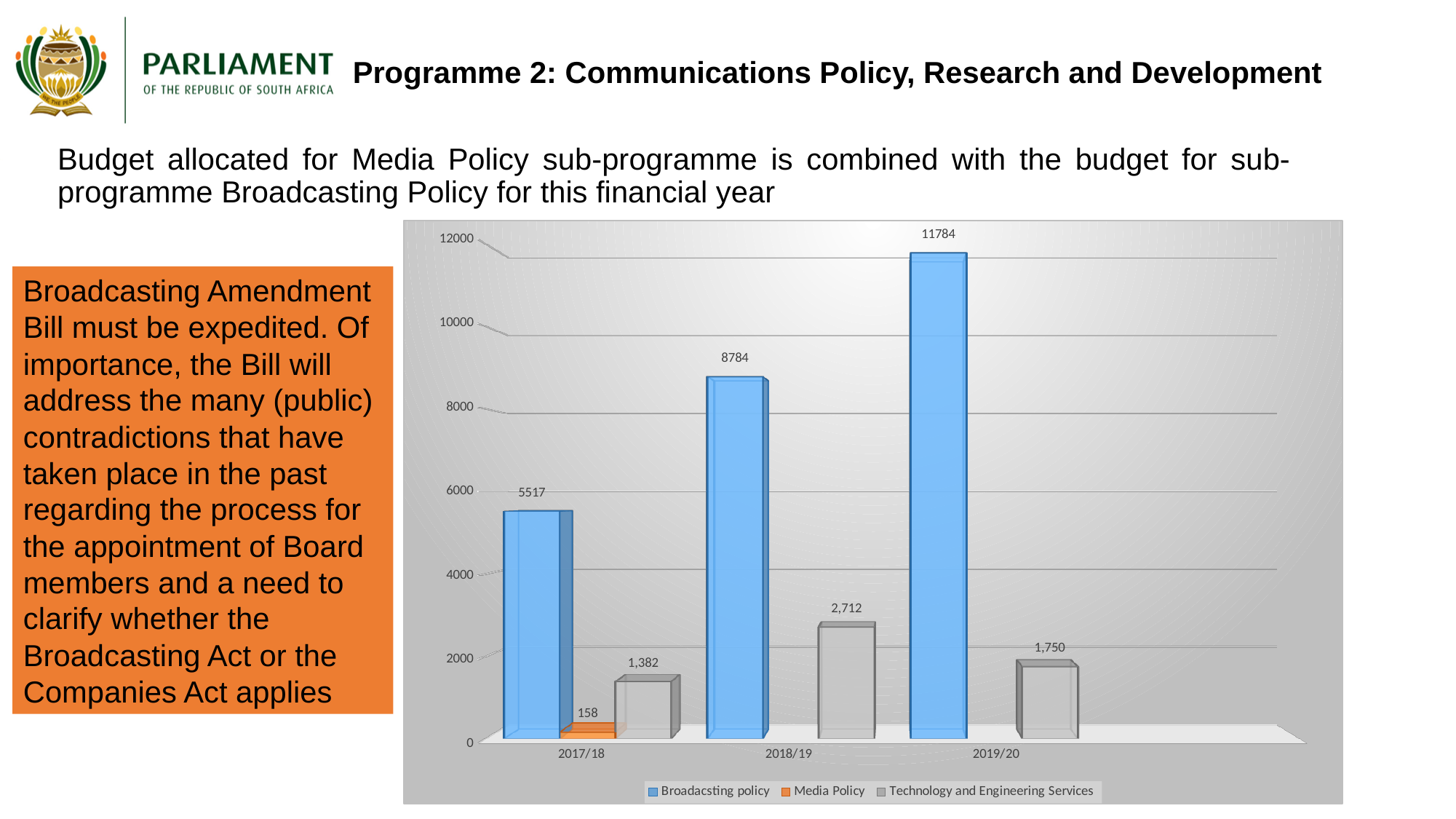
Which is larger: Technology and Engineering Services in 2018/19 or in 2019/20? 2018/19 What is the value for Broadcasting policy in 2019/20? 11784 In which year is the Broadcasting policy value highest? 2019/20 What is the value for Broadcasting policy in 2017/18? 5517 Is the value for Broadcasting policy in 2018/19 greater or less than 8000? greater What is the value for Technology and Engineering Services in 2018/19? 2,712 In which year is the Technology and Engineering Services value lowest? 2017/18 How many series does the legend list? 3 What is the difference between the Broadcasting policy values for 2018/19 and 2017/18? 3267 Does the Broadcasting policy value rise or fall from 2017/18 to 2019/20? rise How many years are shown on the x axis? 3 What is the value for Media Policy in 2017/18? 158